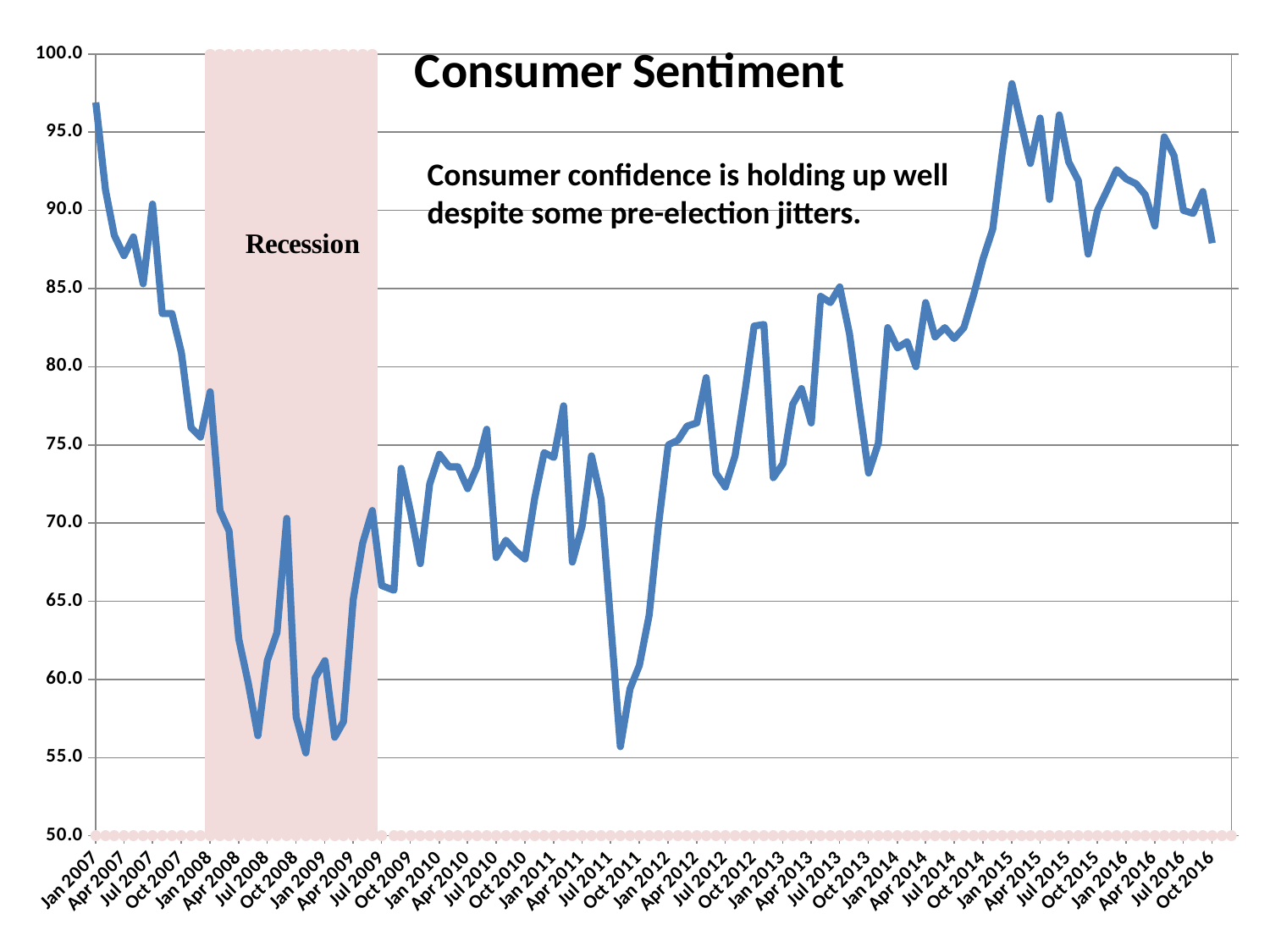
What label is printed inside the shaded region of the chart? Recession Does the line generally rise or fall between Jan 2012 and Jan 2015? rise Is the value for Jan 2015 greater or less than 95? greater What kind of chart is shown on the slide? line chart Does the line generally rise or fall between Jan 2007 and Jan 2009? fall Is the value for Jan 2014 greater or less than 75? greater Is the value for Jul 2008 greater or less than 65? less What is the title of the chart? Consumer Sentiment In which year does the line reach its highest value? 2015